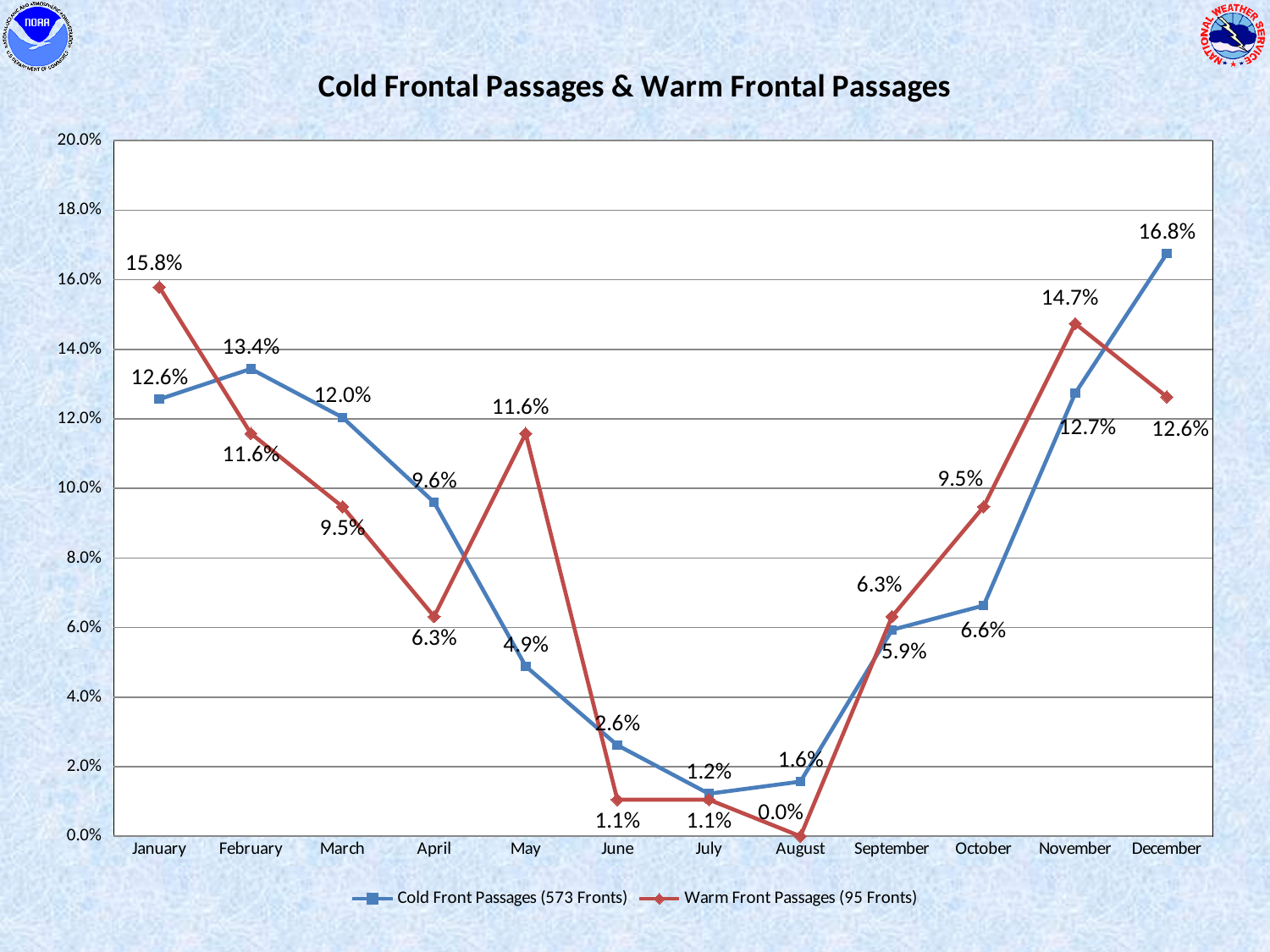
How many months are shown on the x axis? 12 In January, which series has the larger value, Cold Front Passages or Warm Front Passages? Warm Front Passages What is the Warm Front Passages value for May? 11.6% What kind of chart is shown on the slide? Line chart Which month has the highest Cold Front Passages value? December What is the title of the chart? Cold Frontal Passages & Warm Frontal Passages How many series does the legend list? 2 Which month has the lowest Warm Front Passages value? August Do the Cold Front Passages values rise or fall from January to July? Fall What is the Cold Front Passages value for December? 16.8% What is the difference between the Cold Front Passages and Warm Front Passages values in December? 4.2% What is the Warm Front Passages value for January? 15.8%